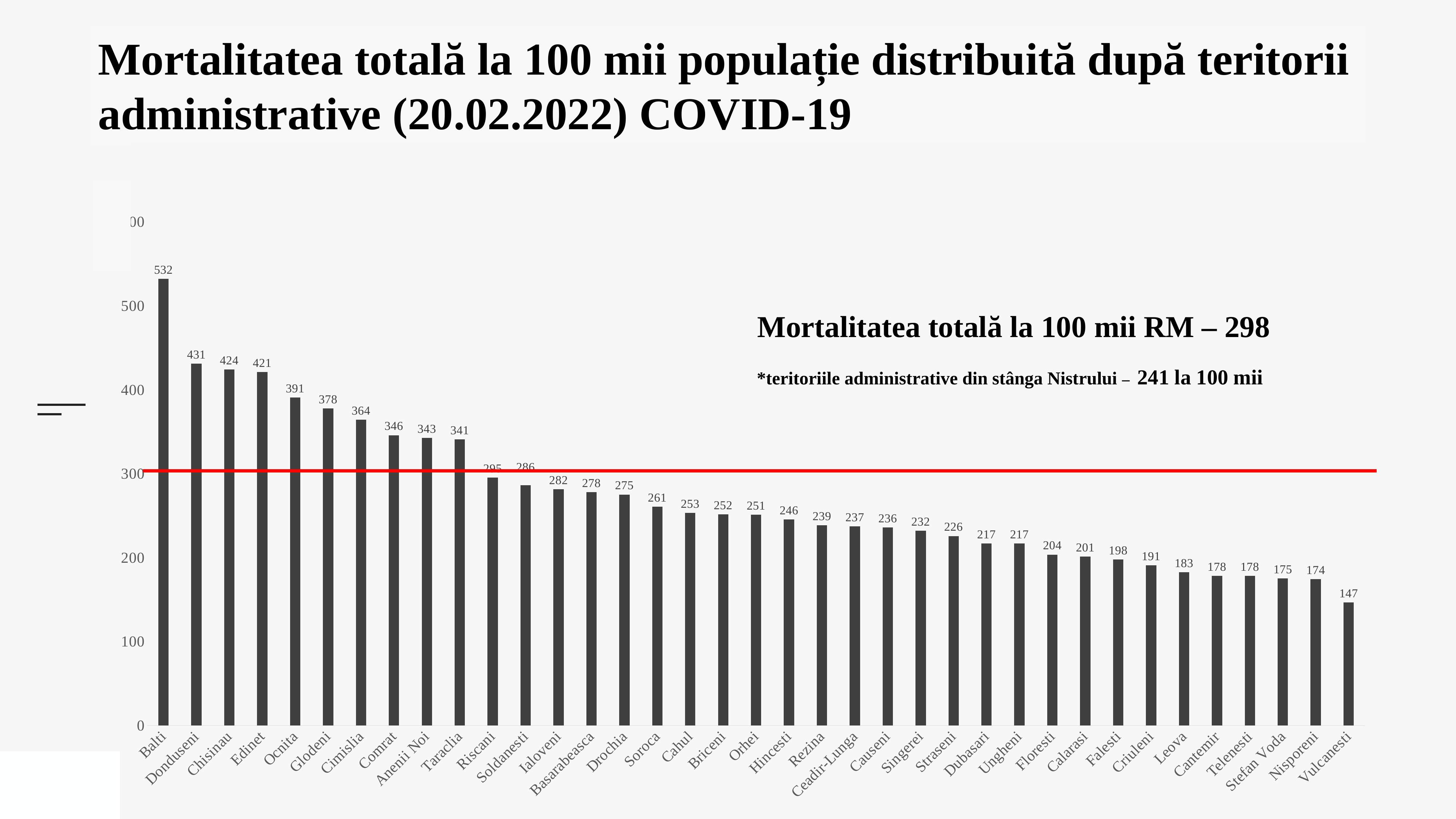
What is the value for Balti? 532 What is the value for Chisinau? 424 How many territories are shown on the chart? 37 What is the value for Cahul? 253 Do the values rise or fall from left to right along the x axis? fall Is the value for Taraclia greater or less than 300? greater Which territory has the lowest value? Vulcanesti What is the difference between the values for Balti and Donduseni? 101 Which territory has the highest value? Balti What kind of chart is shown on the slide? bar chart Which has a larger value, Ocnita or Glodeni? Ocnita What is the value for Vulcanesti? 147